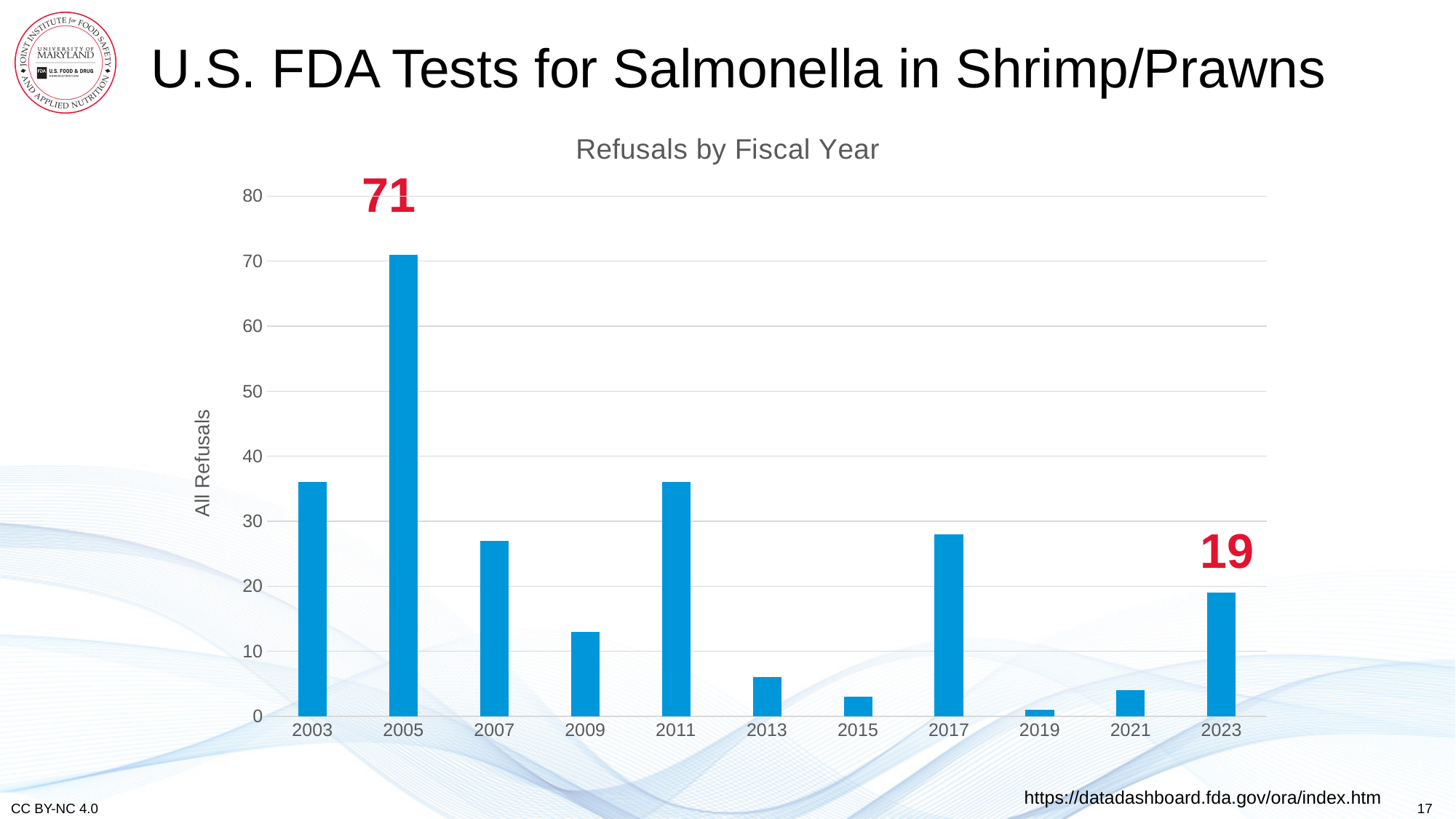
What is the difference between the refusals in 2005 and in 2023? 52 Which fiscal year has the lowest number of refusals? 2019 What kind of chart is shown on the slide? bar chart Is the value for 2009 greater or less than 20? less Which fiscal year has the highest number of refusals? 2005 What is the value for 2023 in the Refusals by Fiscal Year chart? 19 What is the label on the vertical axis of the chart? All Refusals How many fiscal years are shown on the x axis of the chart? 11 Which year has more refusals, 2017 or 2021? 2017 Which year has more refusals, 2003 or 2007? 2003 What is the value for 2005 in the Refusals by Fiscal Year chart? 71 Is the value for 2003 greater or less than 30? greater